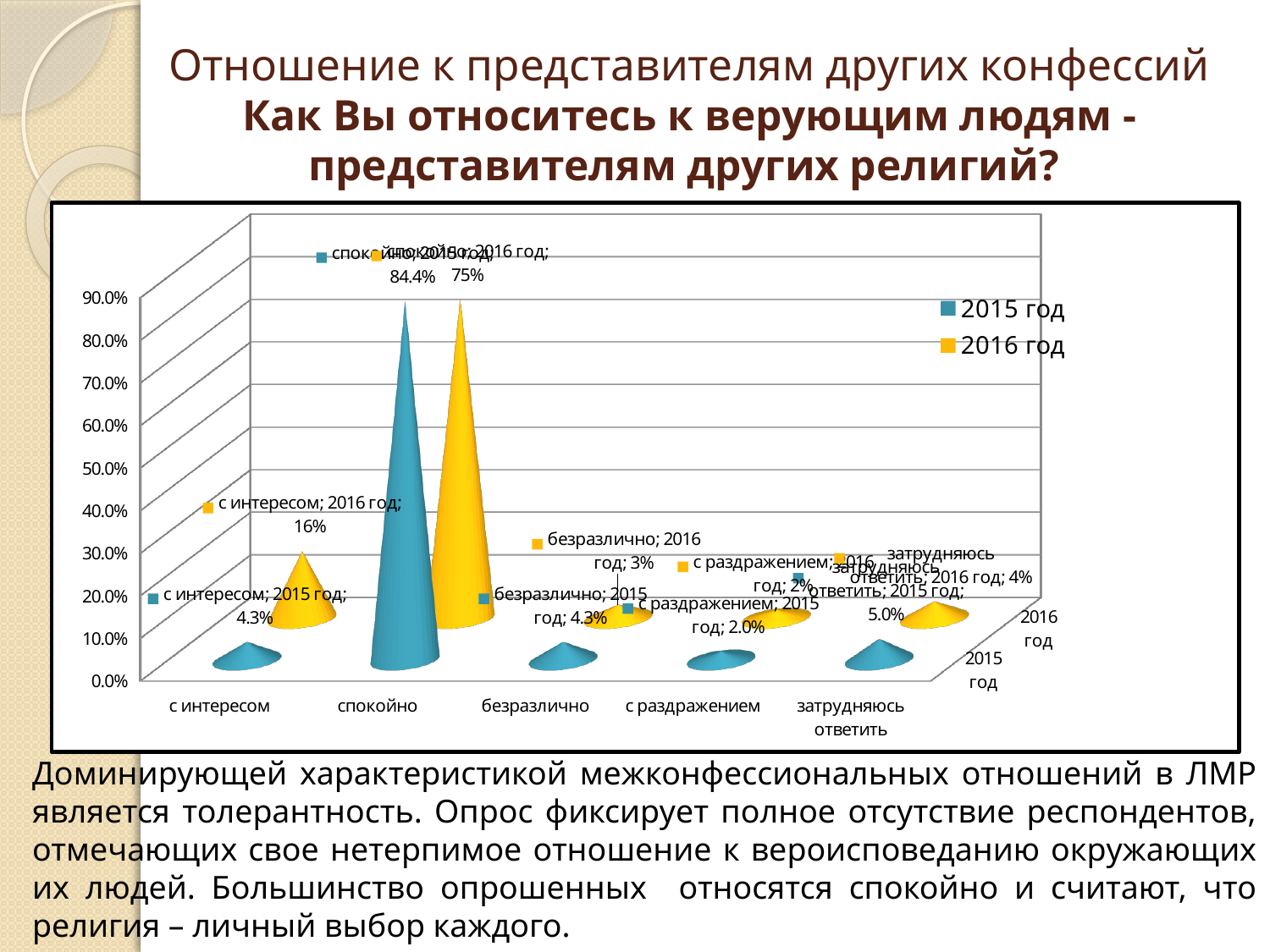
How many series does the legend list? 2 What is the value for с интересом in the 2016 год series? 16% Which is larger for с интересом: the 2015 год value or the 2016 год value? 2016 год What is the value for спокойно in the 2015 год series? 84.4% What is the value for затрудняюсь ответить in the 2015 год series? 5.0% What colour represents the 2016 год series? Yellow Which category has the lowest value in the 2016 год series? с раздражением What is the difference between the 2015 год and 2016 год values for спокойно? 9.4% Which category has the highest value in the 2015 год series? спокойно Is the value for спокойно in 2016 год greater or less than 70.0%? greater What is the value for спокойно in the 2016 год series? 75% How many categories are shown on the x axis? 5